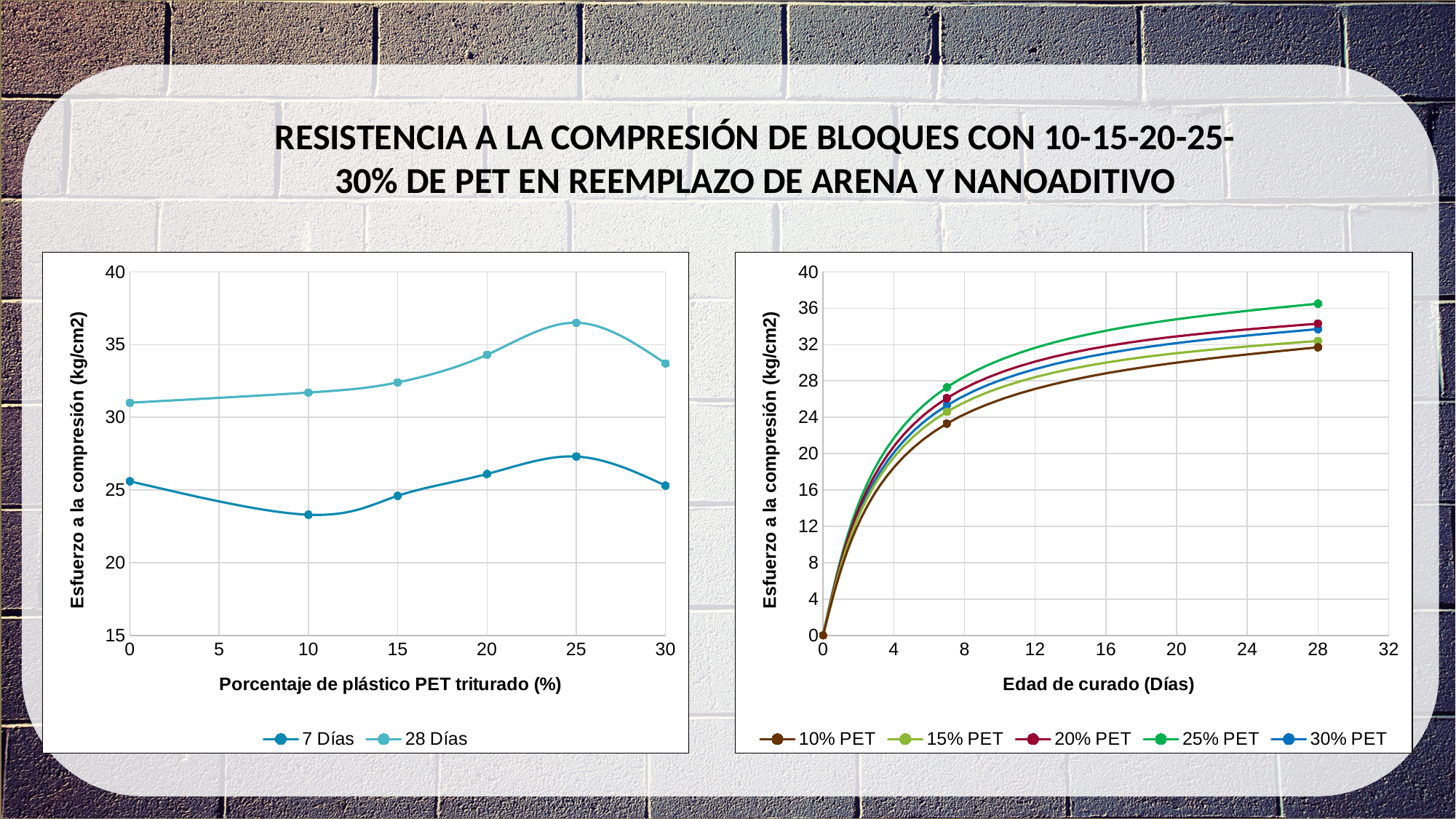
In the right chart, which series has the lowest value at 28 days? 10% PET In the right chart, do the values rise or fall as the curing age increases? rise In the right chart, which series has the highest value at 28 days? 25% PET In the left chart, at which PET percentage does the 7 Días series reach its lowest value? 10 In the left chart, which series has the larger value at 20% PET, 7 Días or 28 Días? 28 Días How many series does the legend of the left chart list? 2 In the right chart, is the value for 10% PET at 7 days greater or less than 24? less In the left chart, is the value for 7 Días at 10% PET greater or less than 25? less How many series does the legend of the right chart (Edad de curado) list? 5 What kind of chart is the left chart (Porcentaje de plástico PET triturado)? line chart In the left chart, at which PET percentage does the 28 Días series reach its highest value? 25 In the left chart, is the value for 28 Días at 0% PET greater or less than 30? greater